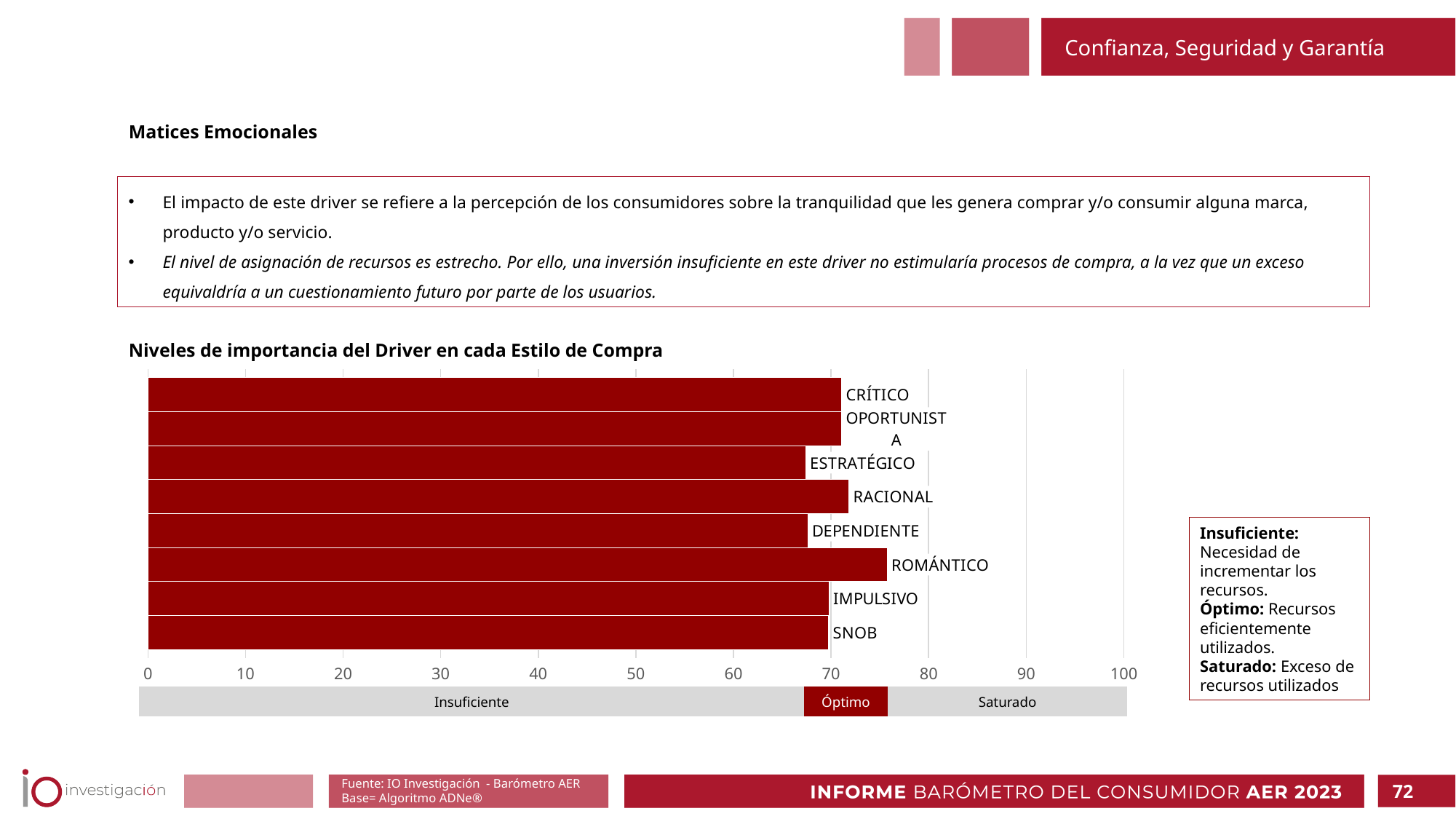
Which purchase style has the highest value in the bar chart? ROMÁNTICO What are the three zone labels shown on the band below the x axis of the chart? Insuficiente, Óptimo, Saturado Is the value for SNOB greater or less than 60? greater Is the value for RACIONAL greater or less than 70? greater Is the value for ESTRATÉGICO greater or less than 70? less What kind of chart is shown under 'Niveles de importancia del Driver en cada Estilo de Compra'? Bar chart Which has a larger value, RACIONAL or DEPENDIENTE? RACIONAL What is the title of the bar chart on the slide? Niveles de importancia del Driver en cada Estilo de Compra Which has a larger value, ROMÁNTICO or ESTRATÉGICO? ROMÁNTICO How many purchase styles (categories) are plotted in the bar chart? 8